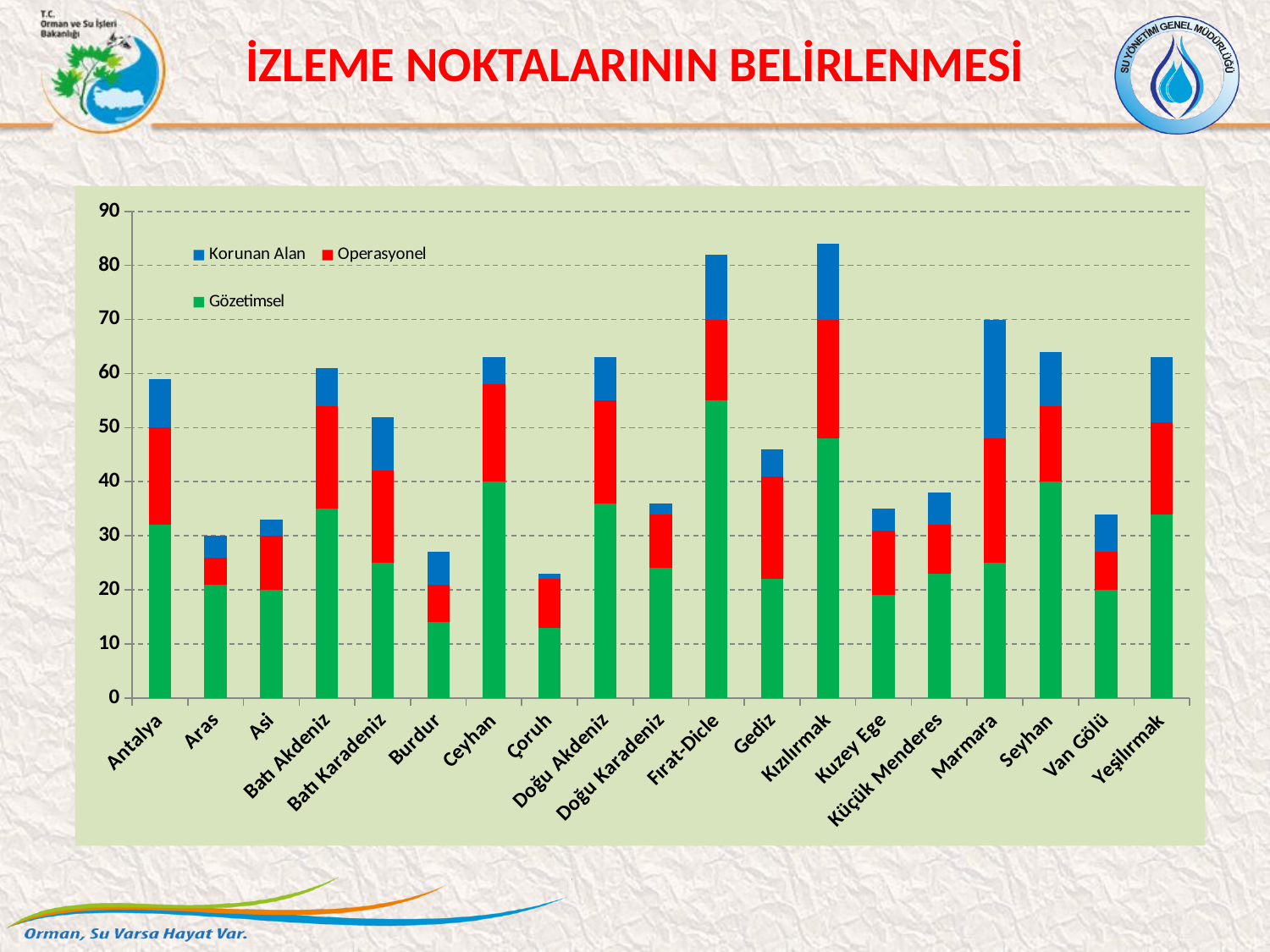
Is the total bar for Fırat-Dicle greater or less than 80? greater Which legend entry is shown in blue? Korunan Alan Is the total bar for Gediz greater or less than 40? greater Is the total bar for Kuzey Ege greater or less than 40? less How many categories (basins) are shown on the x axis? 19 Which category has the largest Gözetimsel (green) segment? Fırat-Dicle Which has the larger total bar, Batı Akdeniz or Batı Karadeniz? Batı Akdeniz Which has the larger total bar, Ceyhan or Aras? Ceyhan Which category has the lowest total bar? Çoruh How many series does the legend list? 3 What kind of chart is shown on the slide? Stacked bar chart